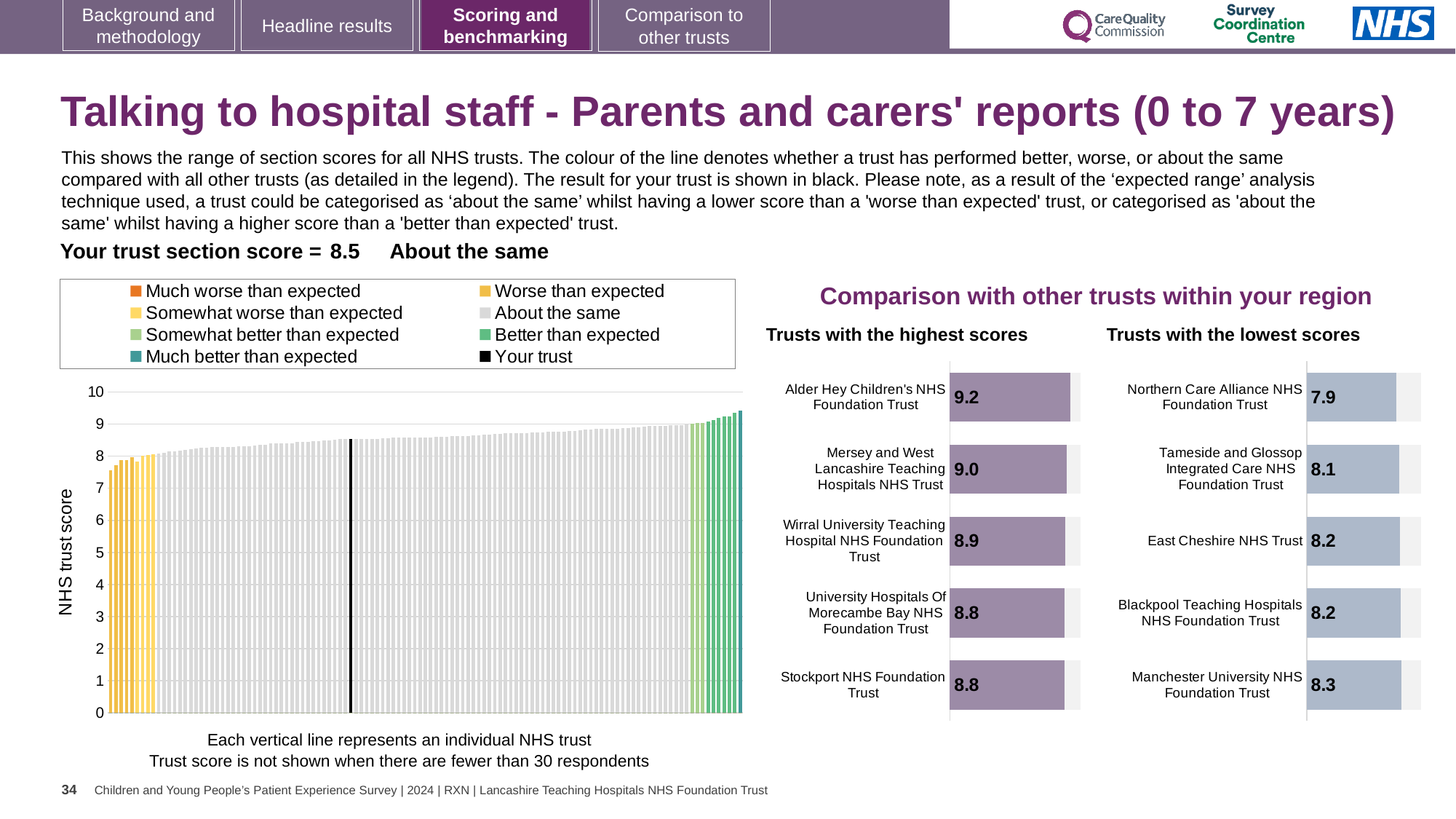
In the main NHS trust score chart, do the values rise or fall from left to right? Rise In the 'Trusts with the lowest scores' chart, which trust has the lowest score? Northern Care Alliance NHS Foundation Trust In the 'Trusts with the highest scores' chart, what is the score for Alder Hey Children's NHS Foundation Trust? 9.2 What kind of chart is the main chart on the left showing NHS trust scores? Bar chart In the 'Trusts with the highest scores' chart, what is the difference between the scores of Alder Hey Children's NHS Foundation Trust and Stockport NHS Foundation Trust? 0.4 Which is larger: the score for Mersey and West Lancashire Teaching Hospitals NHS Trust in the highest scores chart, or the score for Tameside and Glossop Integrated Care NHS Foundation Trust in the lowest scores chart? Mersey and West Lancashire Teaching Hospitals NHS Trust In the 'Trusts with the highest scores' chart, what is the score for Wirral University Teaching Hospital NHS Foundation Trust? 8.9 In the 'Trusts with the lowest scores' chart, which trust has the highest score? Manchester University NHS Foundation Trust What is the section score for your trust shown on the slide? 8.5 In the 'Trusts with the lowest scores' chart, what is the score for Northern Care Alliance NHS Foundation Trust? 7.9 How many entries does the legend of the main NHS trust score chart list? 8 How many trusts are shown in the 'Trusts with the lowest scores' chart? 5